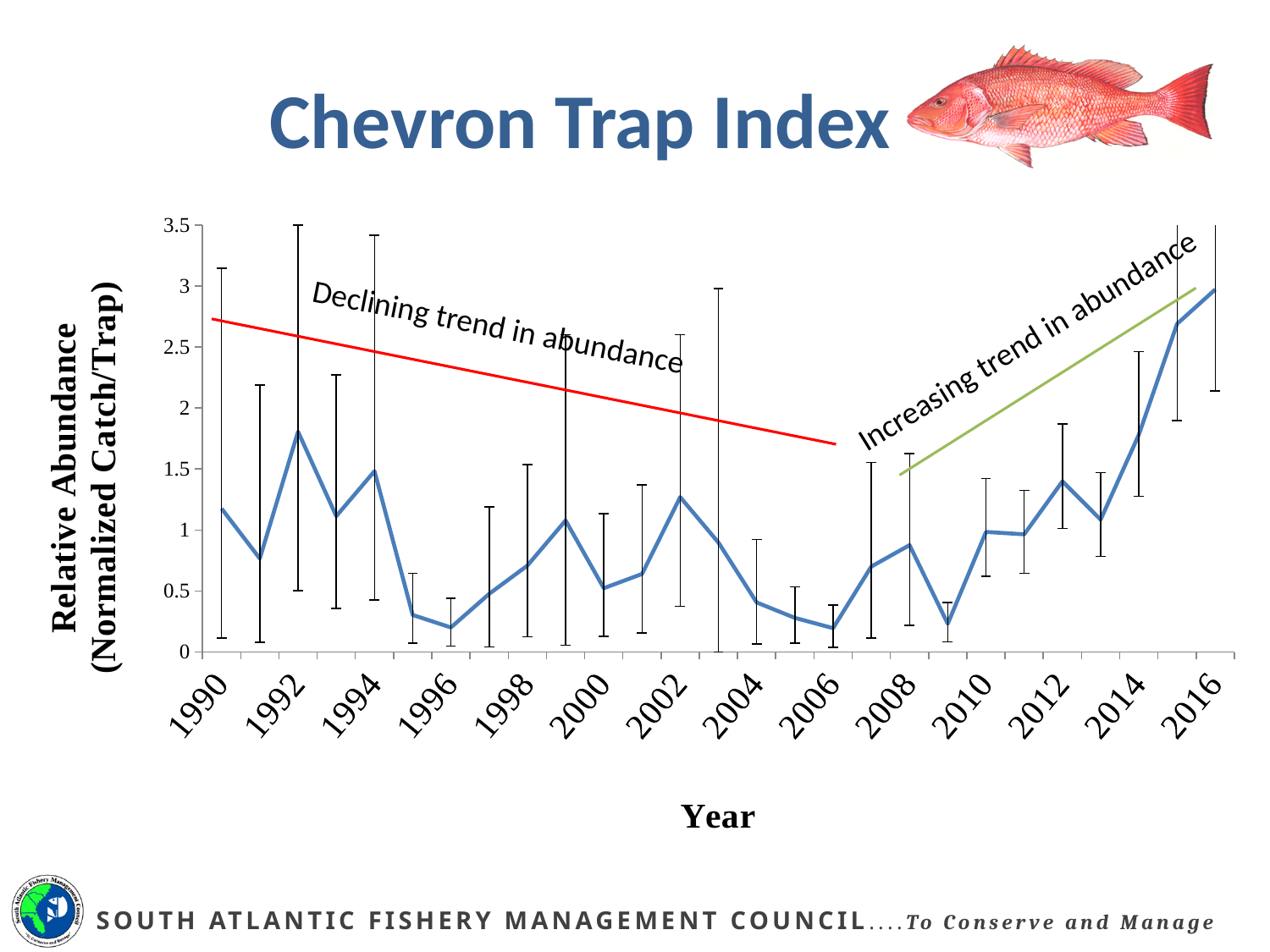
What kind of chart is shown on the slide? line chart Which year has the larger relative abundance value, 1992 or 2016? 2016 Is the relative abundance value for 2016 greater or less than 2.5? greater Is the relative abundance value for 1996 greater or less than 0.5? less Is the relative abundance value for 2006 greater or less than 0.5? less Which year has the highest relative abundance value? 2016 How many year labels are shown on the x axis? 14 Which year has the larger relative abundance value, 2002 or 2004? 2002 What is the label of the y axis? Relative Abundance (Normalized Catch/Trap) Does the relative abundance rise or fall from 2006 to 2016? rise